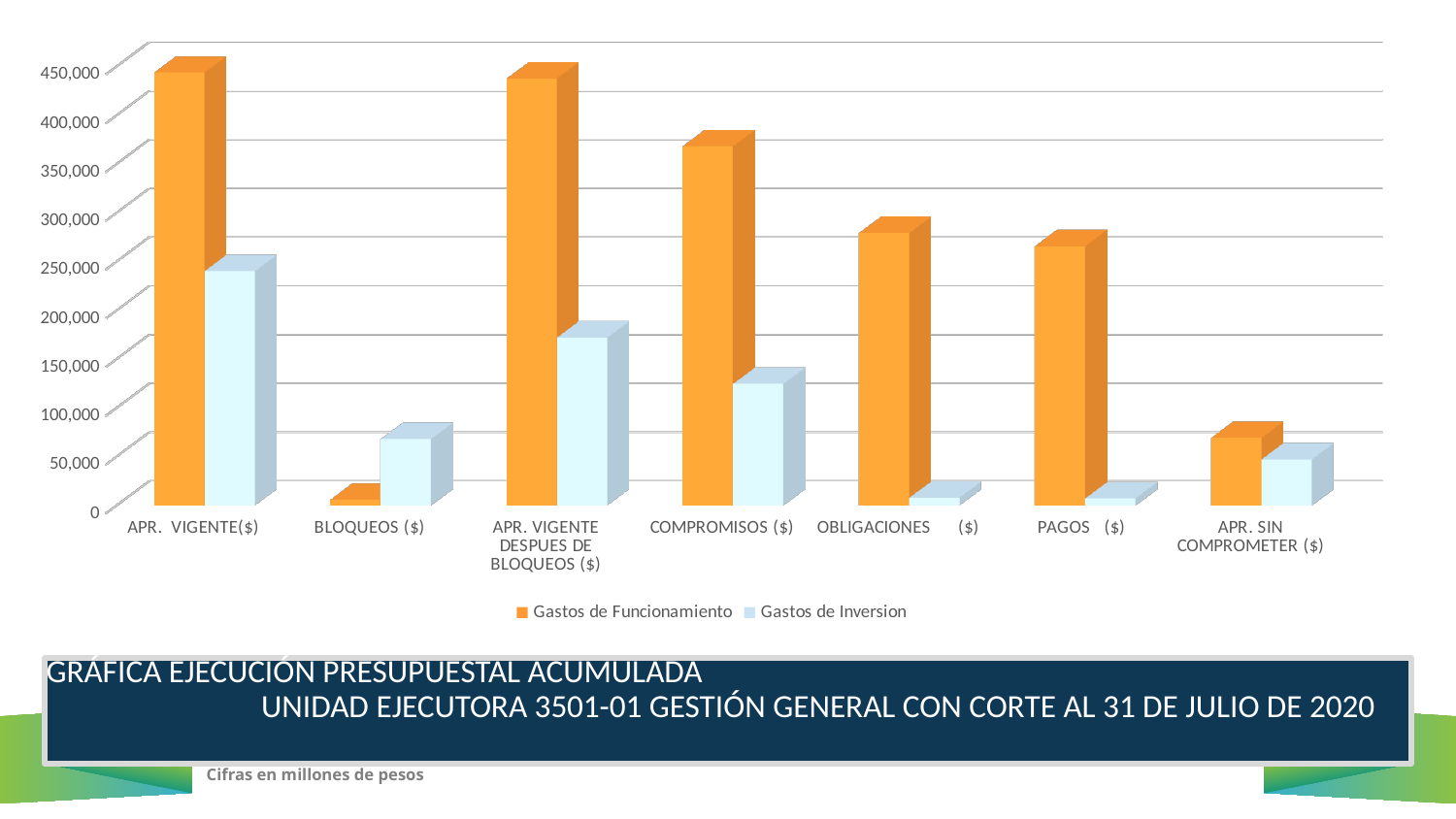
For COMPROMISOS ($), which series has the larger value, Gastos de Funcionamiento or Gastos de Inversion? Gastos de Funcionamiento Is the Gastos de Funcionamiento value for COMPROMISOS ($) greater or less than 350,000? greater For BLOQUEOS ($), which series has the larger value, Gastos de Funcionamiento or Gastos de Inversion? Gastos de Inversion Is the Gastos de Inversion value for COMPROMISOS ($) greater or less than 100,000? greater How many series does the legend list? 2 Is the Gastos de Funcionamiento value for OBLIGACIONES ($) greater or less than 300,000? less How many categories are shown on the x axis? 7 Which category has the lowest value for Gastos de Funcionamiento? BLOQUEOS ($) Which colour represents Gastos de Funcionamiento in the legend? Orange What kind of chart is shown on the slide? Bar chart Which category has the highest value for Gastos de Inversion? APR. VIGENTE($)